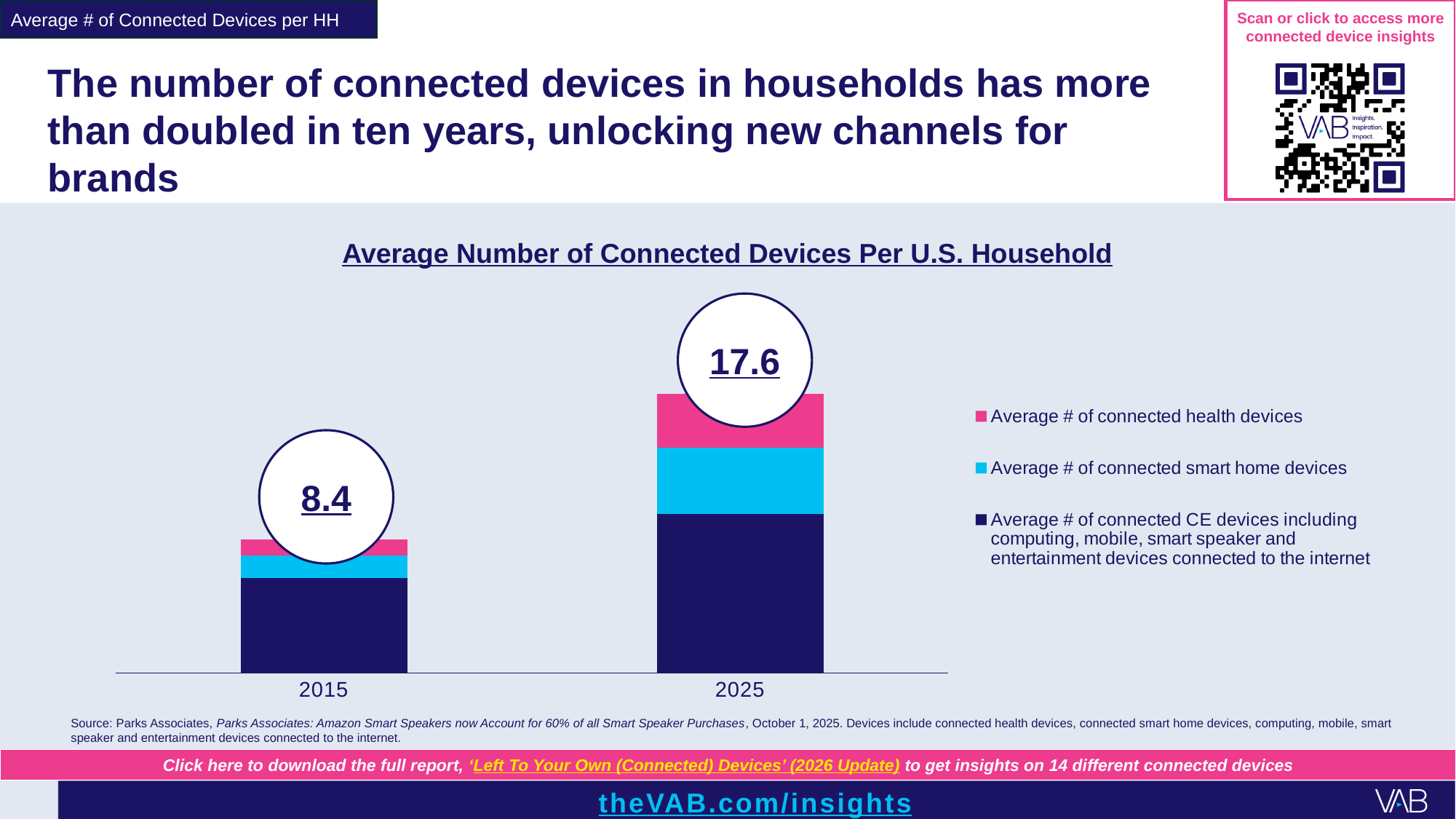
What is the title of the chart? Average Number of Connected Devices Per U.S. Household Which year has the lowest total average number of connected devices per household? 2015 What kind of chart is used to show the average number of connected devices per U.S. household? Stacked bar chart What is the total average number of connected devices per U.S. household shown for 2015? 8.4 How many years (categories) are plotted on the chart? 2 By how much does the total for 2025 exceed the total for 2015? 9.2 Which series is shown in pink in the chart legend? Average # of connected health devices Which year has the higher total average number of connected devices per household? 2025 Does the total average number of connected devices per household rise or fall from 2015 to 2025? Rise What is the total average number of connected devices per U.S. household shown for 2025? 17.6 How many series does the chart legend list? 3 Which year has the highest total average number of connected devices per household? 2025